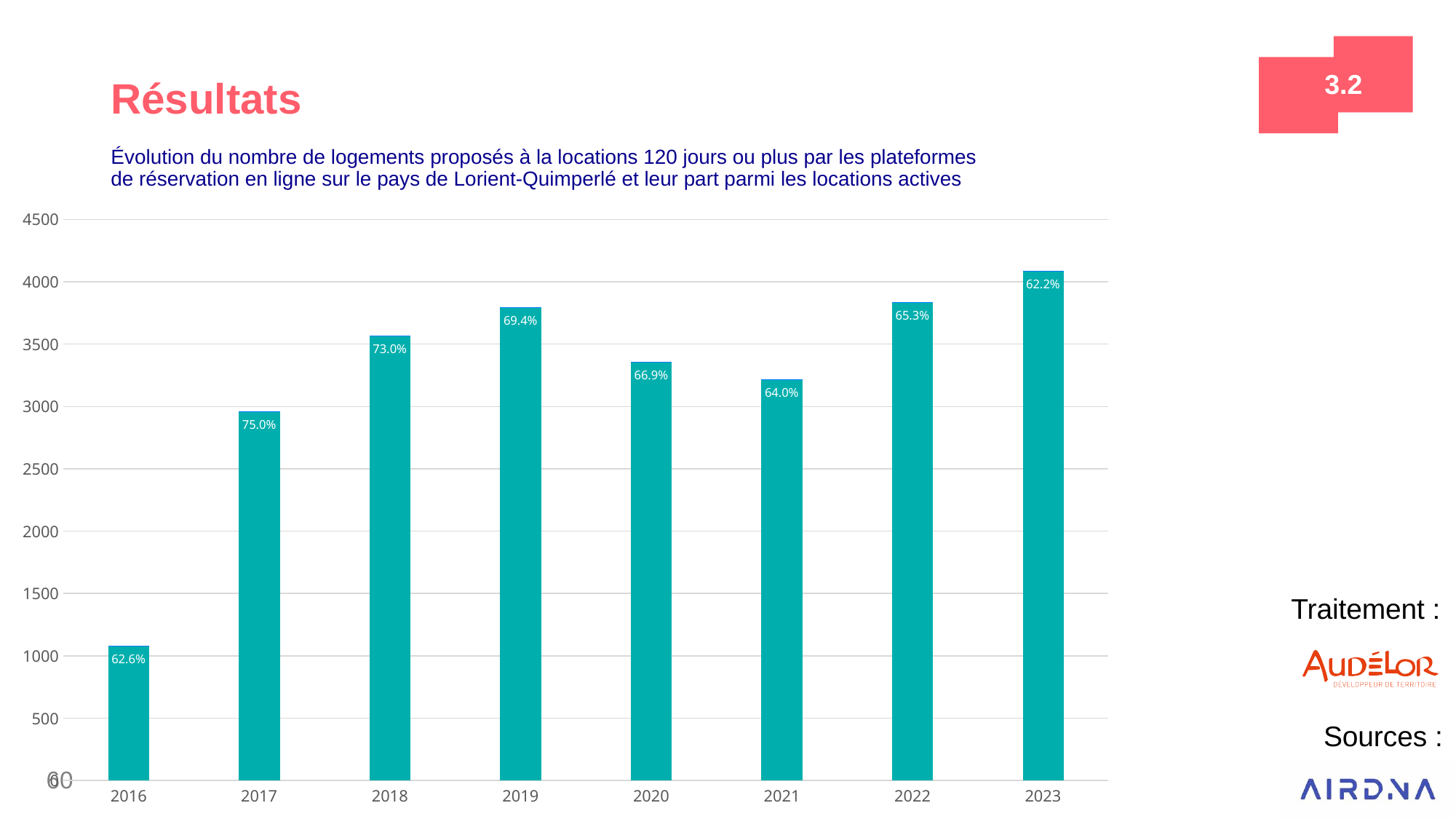
What kind of chart is shown on the slide? Bar chart Is the value for 2023 greater or less than 4000? greater What percentage label is shown on the bar for 2020? 66.9% Is the value for 2016 greater or less than 1500? less Which year shows the highest percentage label? 2017 Which year has the tallest bar (the largest number of logements)? 2023 How many years are shown on the x axis? 8 What percentage label is shown on the bar for 2023? 62.2% Which year has the taller bar, 2018 or 2020? 2018 What percentage label is shown on the bar for 2017? 75.0% Which year has the shortest bar (the smallest number of logements)? 2016 What is the difference in percentage points between the 2017 label (75.0%) and the 2023 label (62.2%)? 12.8 percentage points